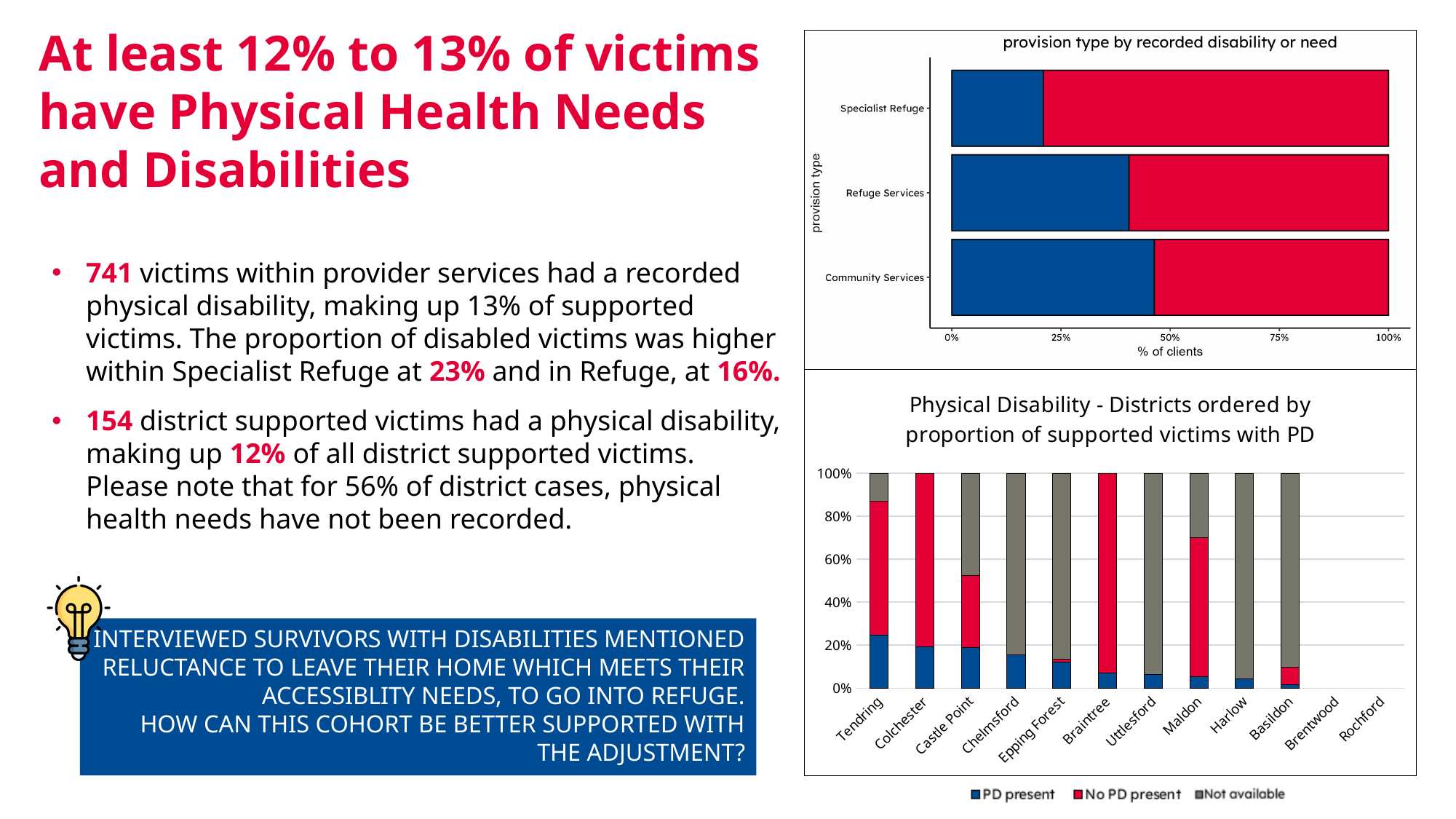
In the 'Physical Disability' districts chart, is the 'PD present' value for Tendring greater or less than 20%? greater What kind of chart is the 'provision type by recorded disability or need' chart? bar chart In the 'Physical Disability' districts chart, which district has a larger 'PD present' proportion, Chelmsford or Harlow? Chelmsford In the 'Physical Disability' districts chart, does the 'PD present' proportion rise or fall from left to right across the districts? fall In the 'provision type by recorded disability or need' chart, which provision type has the smallest blue portion? Specialist Refuge In the 'Physical Disability' districts chart, which district has the highest proportion of 'PD present'? Tendring How many series does the legend of the 'Physical Disability - Districts ordered by proportion of supported victims with PD' chart list? 3 In the 'provision type by recorded disability or need' chart, what is the x-axis label? % of clients In the 'provision type by recorded disability or need' chart, is the blue portion for Specialist Refuge greater or less than 25%? less In the 'provision type by recorded disability or need' chart, is the blue portion for Community Services greater or less than 50%? less How many provision types are shown in the 'provision type by recorded disability or need' chart? 3 How many districts are shown in the 'Physical Disability - Districts ordered by proportion of supported victims with PD' chart? 12